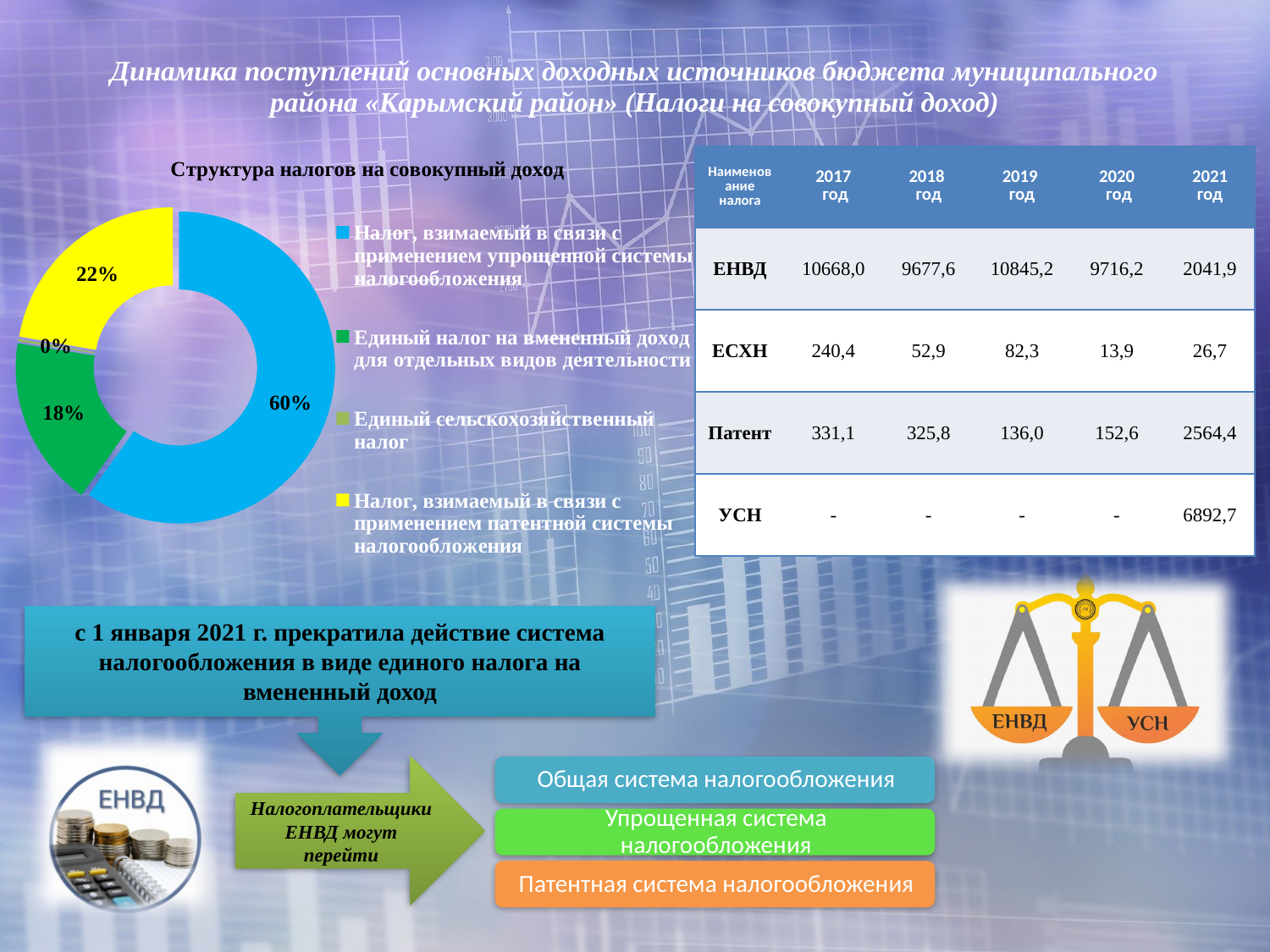
What type of chart is shown under the heading «Структура налогов на совокупный доход»? Doughnut (pie) chart How many categories does the legend of the doughnut chart list? 4 In the doughnut chart, what share is shown for the tax levied under the simplified taxation system (упрощенная система налогообложения)? 60% What colour is the slice representing the patent taxation system tax in the doughnut chart? Yellow What is the title of the doughnut chart on the slide? Структура налогов на совокупный доход Which category has the largest slice in the doughnut chart? Налог, взимаемый в связи с применением упрощенной системы налогообложения In the doughnut chart, what share is shown for the tax levied under the patent taxation system (патентная система налогообложения)? 22% In the doughnut chart, what share is shown for the unified tax on imputed income (единый налог на вмененный доход)? 18% In the doughnut chart, what is the difference in percentage points between the simplified-system tax slice and the patent-system tax slice? 38 In the doughnut chart, what share is shown for the unified agricultural tax (единый сельскохозяйственный налог)? 0% Which category has the smallest slice in the doughnut chart? Единый сельскохозяйственный налог In the doughnut chart, which slice is larger: the patent-system tax or the unified tax on imputed income? Patent-system tax (22%)